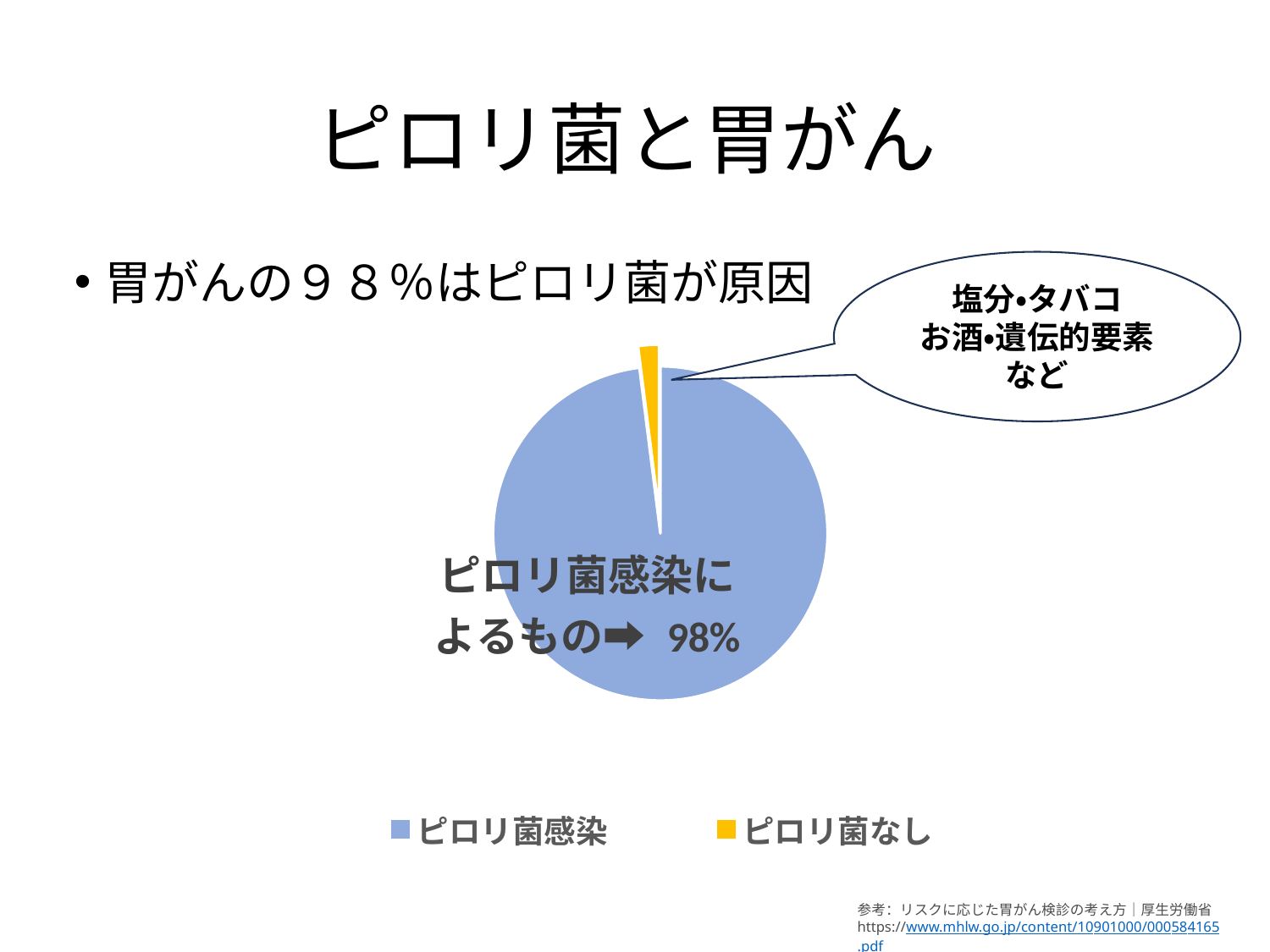
Is the share of the ピロリ菌感染 slice greater or less than 50%? greater What kind of chart is shown on the slide? pie chart What share of the pie does the ピロリ菌感染 slice represent? 98% Is the share of the ピロリ菌なし slice greater or less than 10%? less Which slice of the pie chart is the largest? ピロリ菌感染 What colour is the ピロリ菌なし slice in the pie chart? yellow Which is larger in the pie chart, ピロリ菌感染 or ピロリ菌なし? ピロリ菌感染 How many entries does the legend of the pie chart list? 2 Which slice of the pie chart is the smallest? ピロリ菌なし What colour is the ピロリ菌感染 slice in the pie chart? blue How many slices does the pie chart have? 2